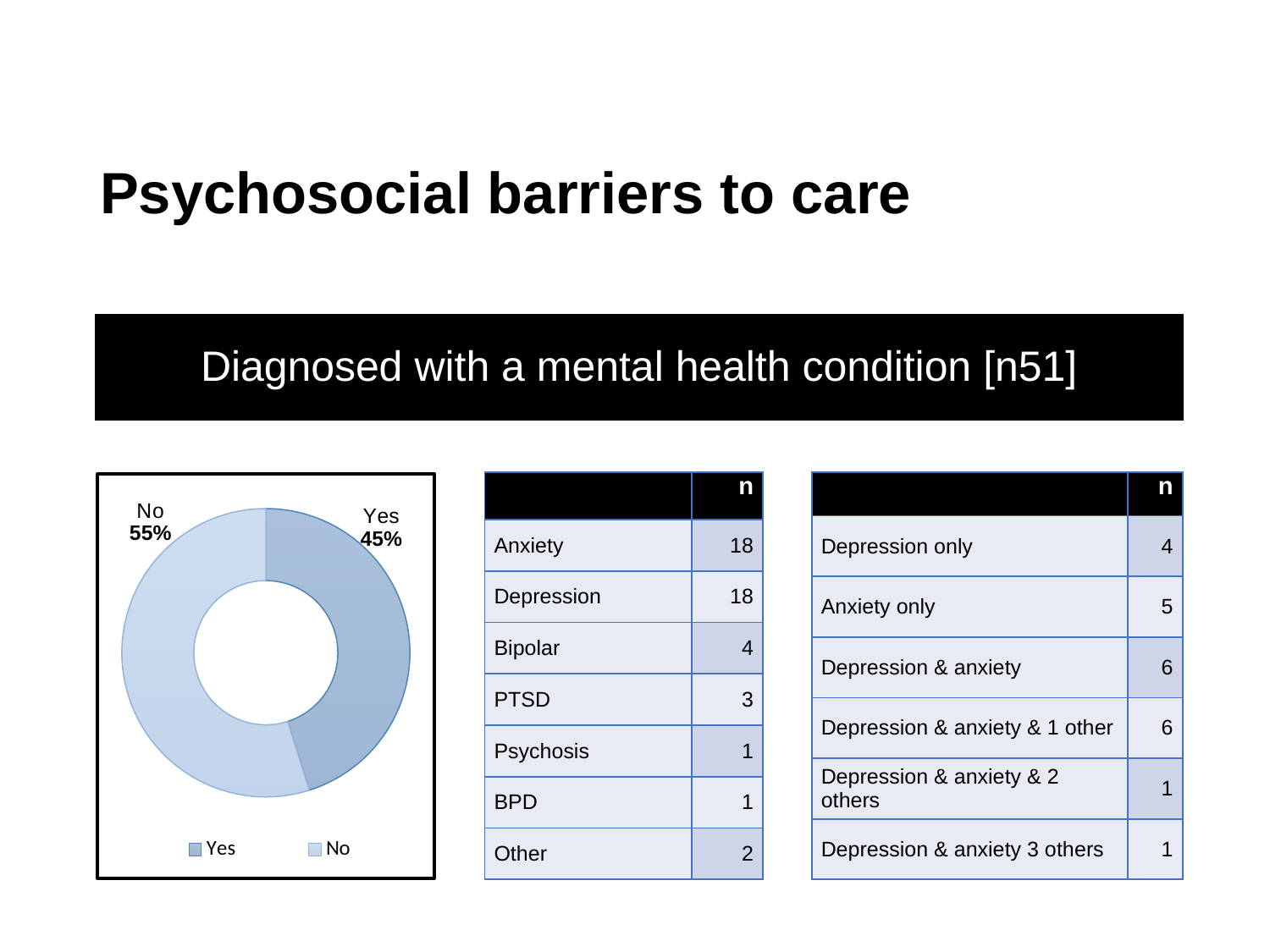
What is the total of the two percentages shown on the doughnut chart? 100% Which category has the largest share in the doughnut chart? No What percentage of the doughnut chart is labelled Yes? 45% How many entries does the legend of the doughnut chart list? 2 What percentage of the doughnut chart is labelled No? 55% How many slices does the doughnut chart have? 2 Which slice of the doughnut chart is larger, Yes or No? No Is the Yes slice of the doughnut chart greater or less than half of the chart? less What kind of chart is shown on the slide? Doughnut chart Which category has the smallest share in the doughnut chart? Yes What is the difference in percentage points between the No and Yes slices of the doughnut chart? 10 What are the two legend entries of the doughnut chart? Yes and No